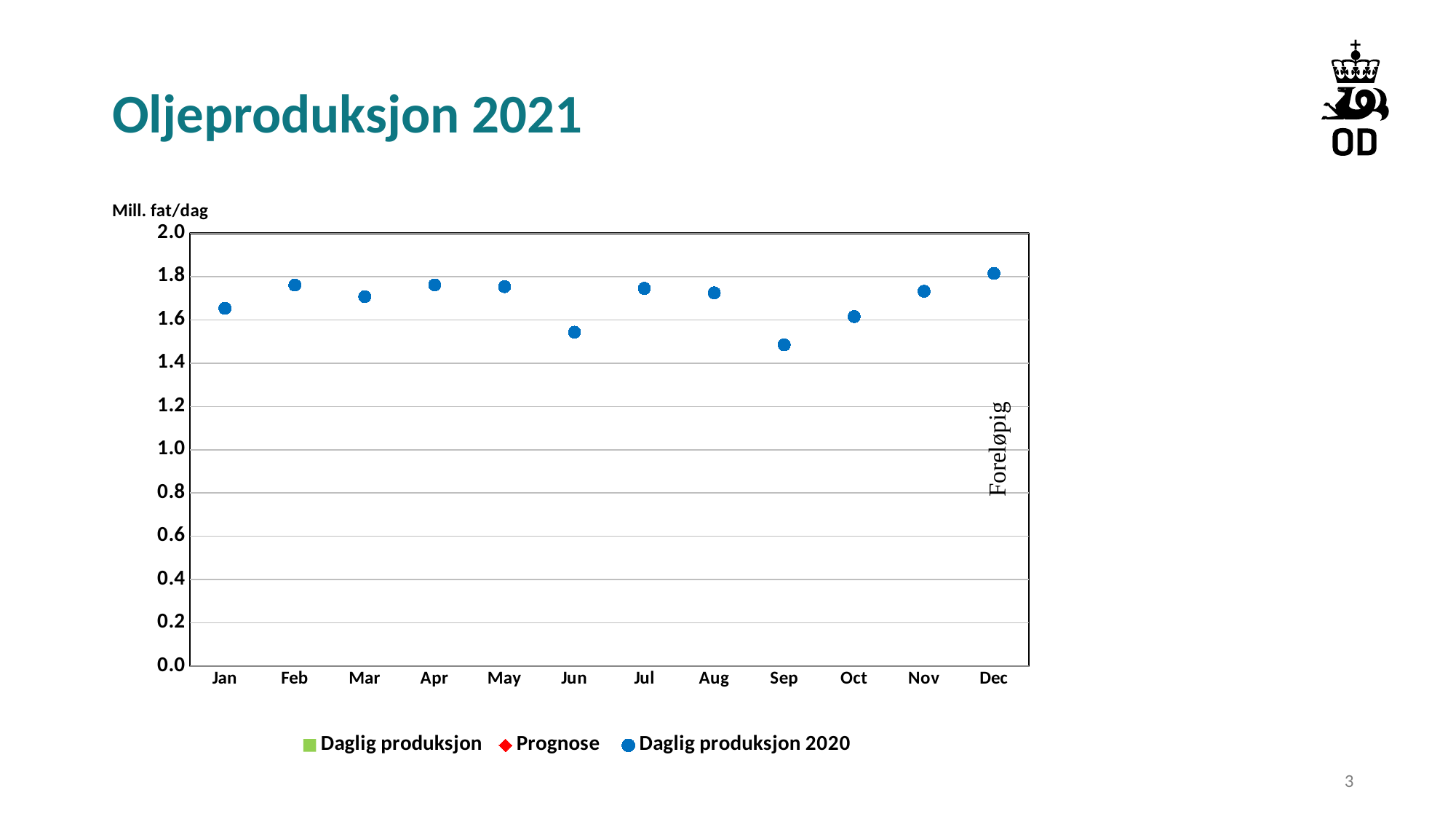
Is the value for Daglig produksjon 2020 in Oct greater or less than 1.4? greater What is the title of the slide? Oljeproduksjon 2021 Which month has the lowest value for Daglig produksjon 2020? Sep What unit is shown on the y axis? Mill. fat/dag Which is larger for Daglig produksjon 2020, Feb or Jun? Feb Is the value for Daglig produksjon 2020 in Sep greater or less than 1.6? less Is the value for Daglig produksjon 2020 in Jun greater or less than 1.6? less Which month has the highest value for Daglig produksjon 2020? Dec How many months are plotted on the x axis? 12 How many series does the legend list? 3 Which is larger for Daglig produksjon 2020, Jun or Sep? Jun